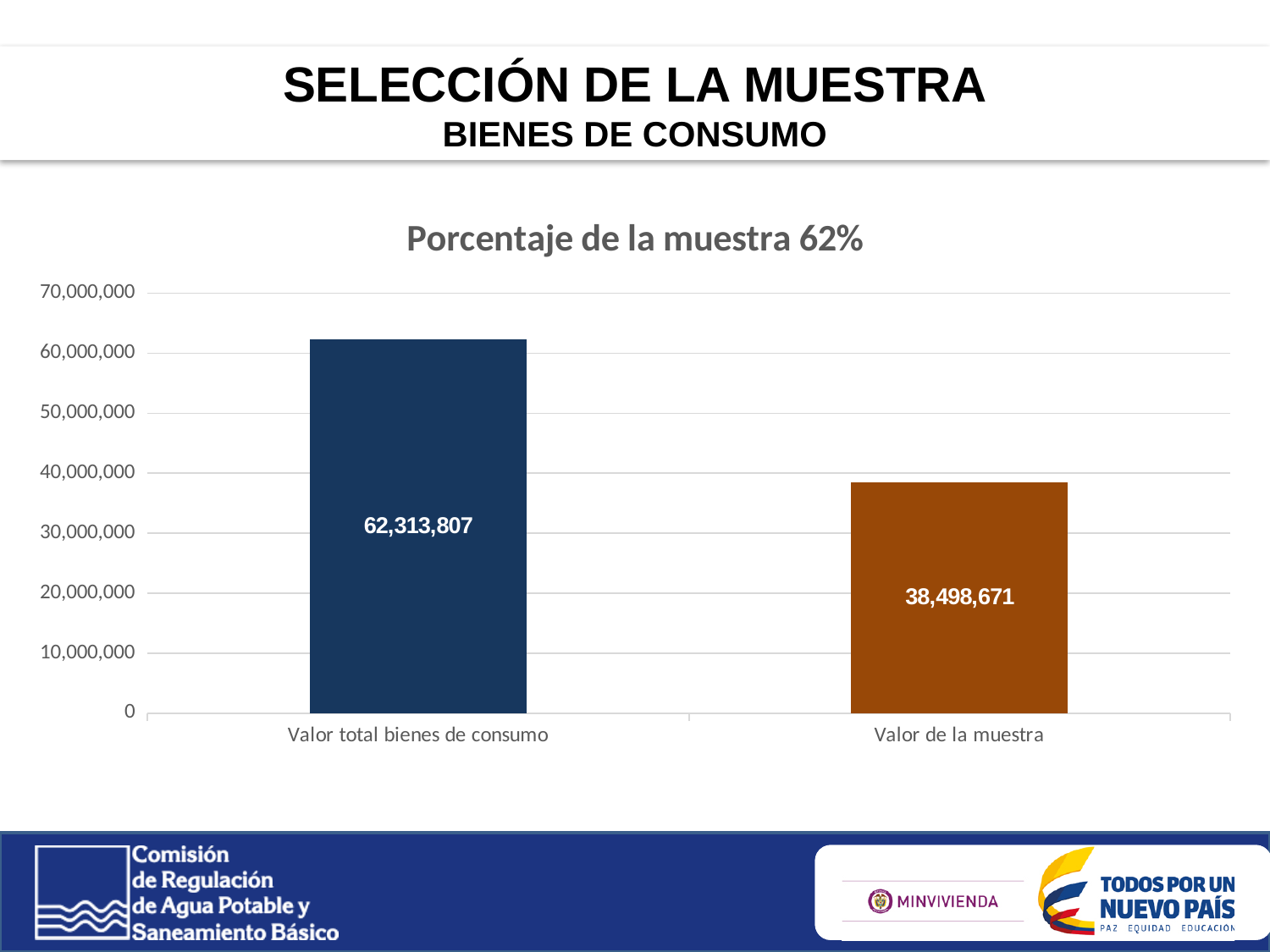
Which category has the highest value? Valor total bienes de consumo What is the difference between Valor total bienes de consumo and Valor de la muestra? 23,815,136 Is the value for Valor total bienes de consumo greater or less than 60,000,000? greater Which category has the lowest value? Valor de la muestra What kind of chart is shown on the slide? bar chart What is the value for Valor total bienes de consumo? 62,313,807 Which is larger, Valor total bienes de consumo or Valor de la muestra? Valor total bienes de consumo Is the value for Valor de la muestra greater or less than 40,000,000? less What is the highest value shown on the vertical axis? 70,000,000 How many categories are shown in the chart? 2 What is the value for Valor de la muestra? 38,498,671 What is the title of the chart? Porcentaje de la muestra 62%